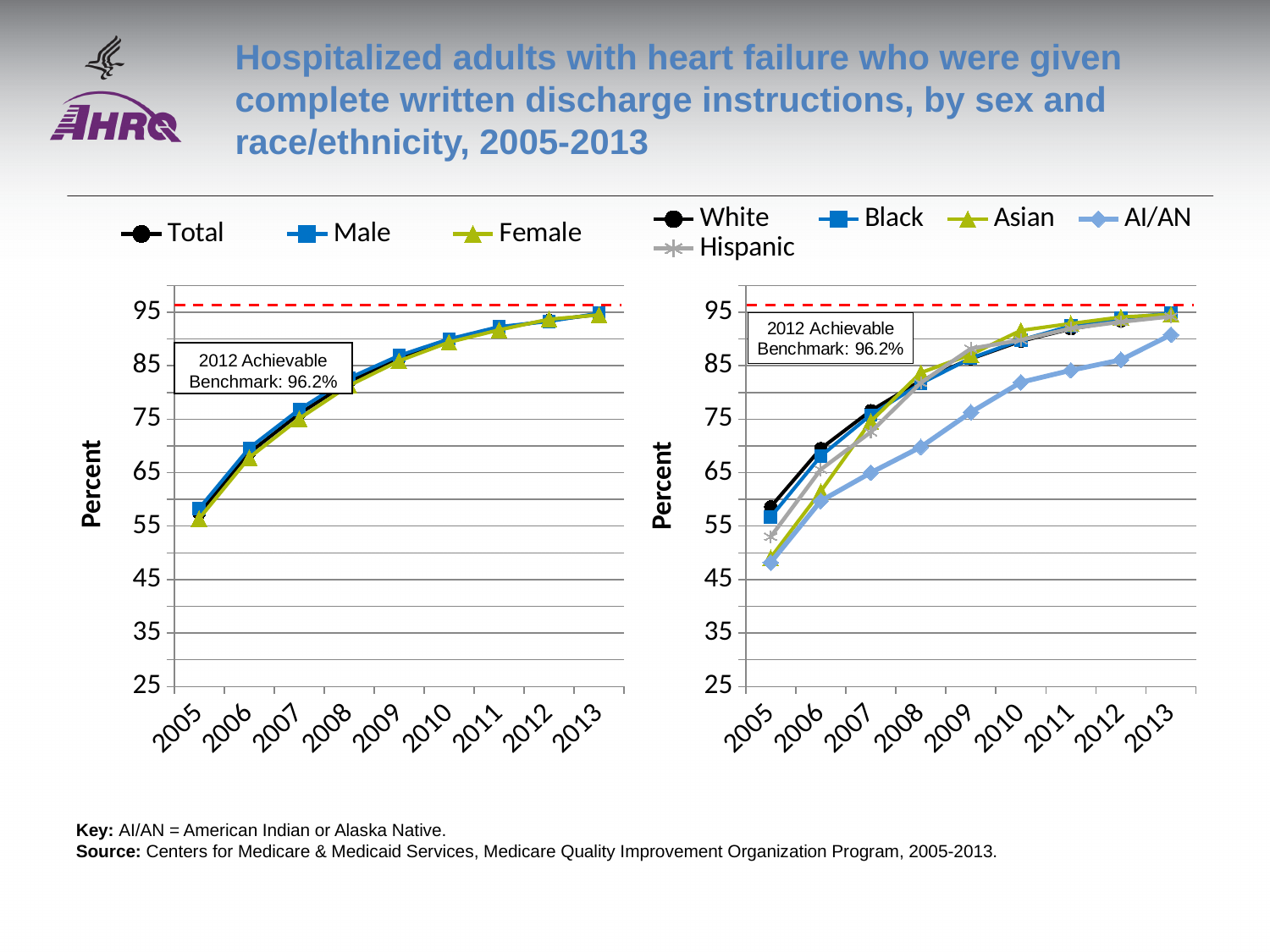
How many series does the legend of the left chart (by sex) list? 3 What kind of chart is the left chart (Total, Male, Female)? line chart In the right chart, does the AI/AN series rise or fall from 2005 to 2013? rise What is the 2012 Achievable Benchmark shown by the dashed line on both charts? 96.2% In the right chart, is the value for AI/AN in 2010 greater or less than 85? less In the right chart, which group has the lowest value in 2013? AI/AN How many series does the legend of the right chart (by race/ethnicity) list? 5 In the right chart, which group has the lowest value in 2005? AI/AN In the left chart, is the value for Total in 2013 greater or less than 85? greater In the left chart, is the value for Female in 2005 greater or less than 65? less How many years are shown on the x axis of the left chart? 9 In the left chart, does the Total series rise or fall from 2005 to 2013? rise